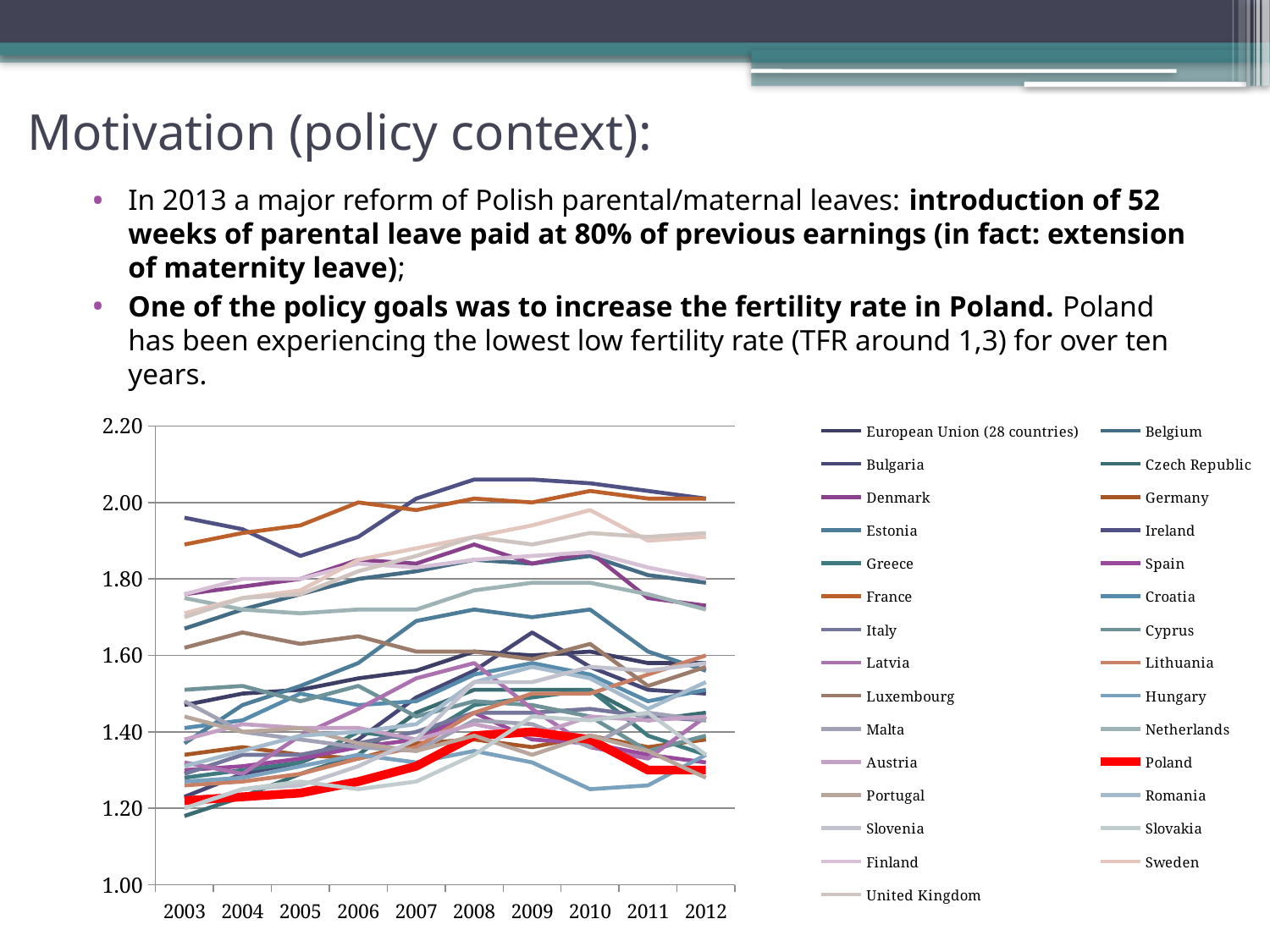
Does the Poland line rise or fall between 2003 and 2008? rise Is the value for Poland in 2009 greater or less than 1.60? less What is the first year shown on the x axis of the chart? 2003 How many years are shown along the x axis of the chart? 10 Is the value for Poland in 2003 greater or less than 1.40? less What kind of chart is shown on the slide? line chart Is the value for Poland in 2010 greater or less than 1.20? greater Does the Poland line rise or fall between 2009 and 2012? fall How many series does the chart's legend list? 29 What is the last year shown on the x axis of the chart? 2012